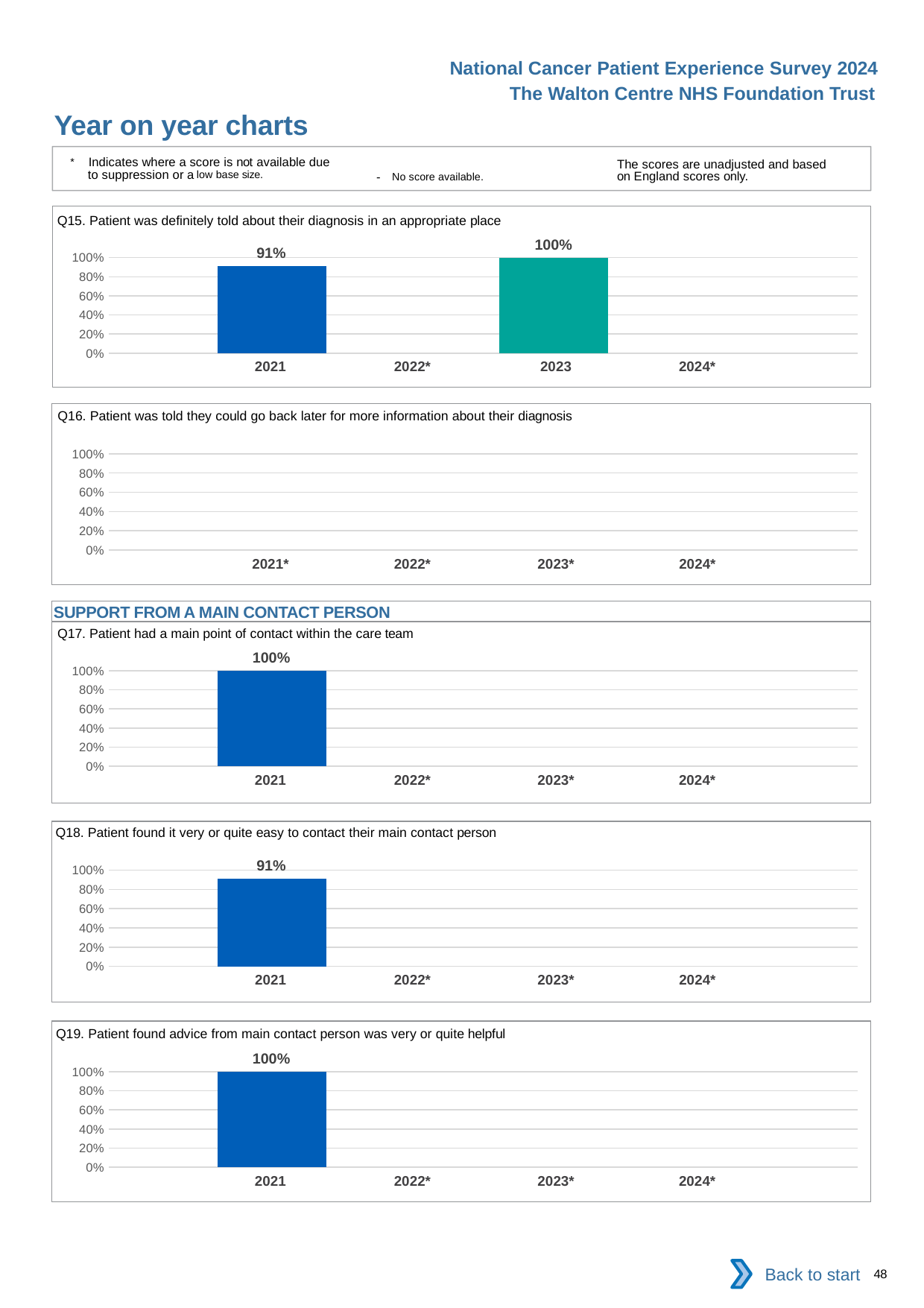
In the Q15 chart, what is the value for 2021? 91% In the Q15 chart, which year has the highest value? 2023 In the Q15 chart, how many years have a plotted bar? 2 In the Q17 chart, what is the value for 2021? 100% In the Q19 chart, what is the value for 2021? 100% In the Q18 chart, is the value for 2021 greater or less than 80%? greater In the Q16 chart, how many years have a plotted bar? 0 In the Q15 chart, what is the value for 2023? 100% What kind of chart is the Q15 chart? Bar chart Which is larger: the 2021 value in the Q17 chart or the 2021 value in the Q18 chart? Q17 chart In the Q18 chart, what is the value for 2021? 91% In the Q15 chart, what is the difference between the 2023 and 2021 values? 9 percentage points